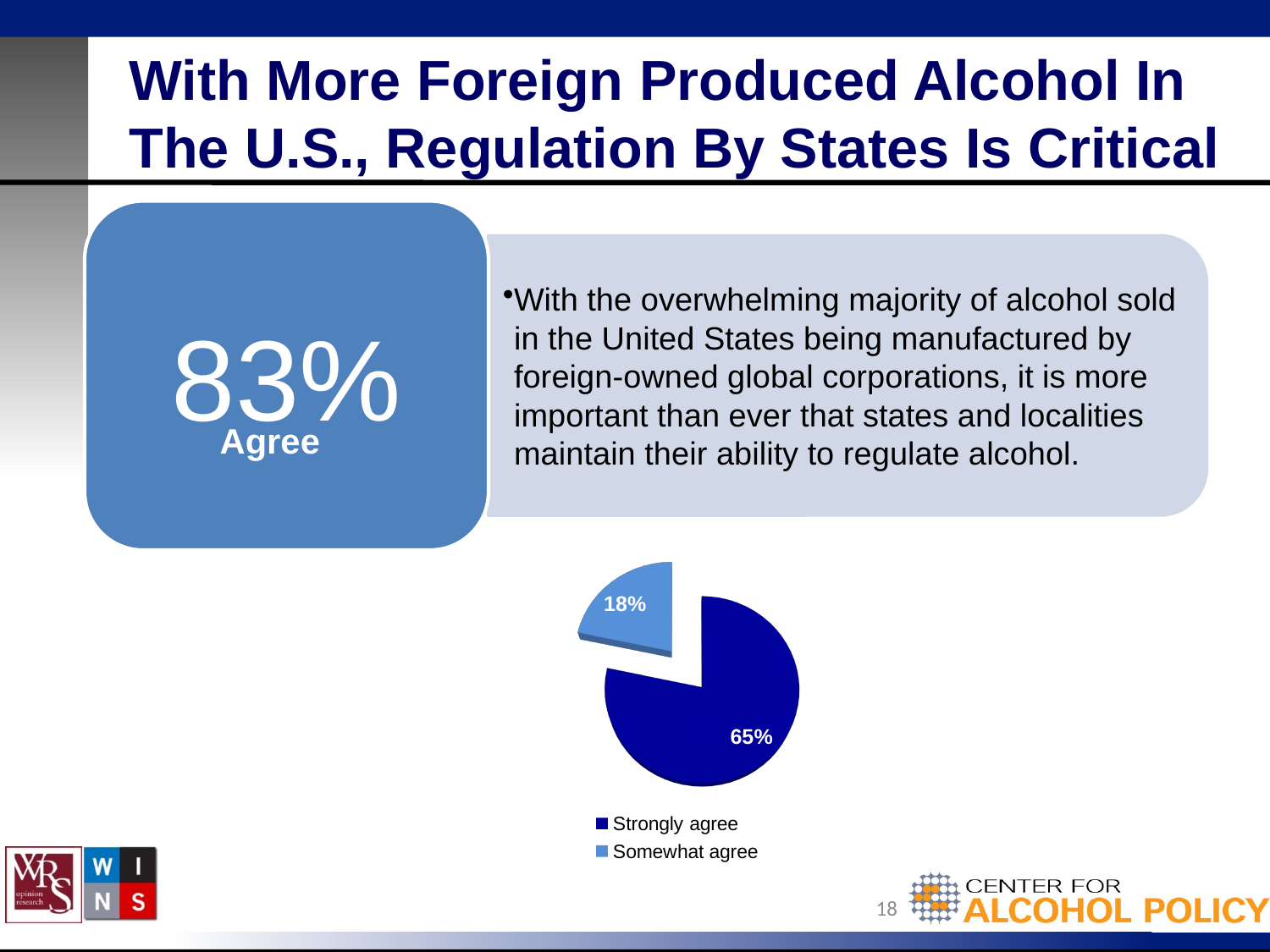
Which slice of the pie chart is the smallest? Somewhat agree What is the difference in percentage points between the Strongly agree and Somewhat agree slices? 47 How many entries does the pie chart's legend list? 2 What share of the pie does the Somewhat agree slice represent? 18% What kind of chart is shown on the slide? pie chart What percentage of the pie chart is labelled for Strongly agree? 65% Which slice of the pie chart is the largest? Strongly agree What percentage of the pie chart is labelled for Somewhat agree? 18% What do the two labelled slices of the pie chart add up to? 83% How many slices does the pie chart have? 2 Which is larger in the pie chart, Strongly agree or Somewhat agree? Strongly agree Which legend entry in the pie chart is shown in the darker blue colour? Strongly agree